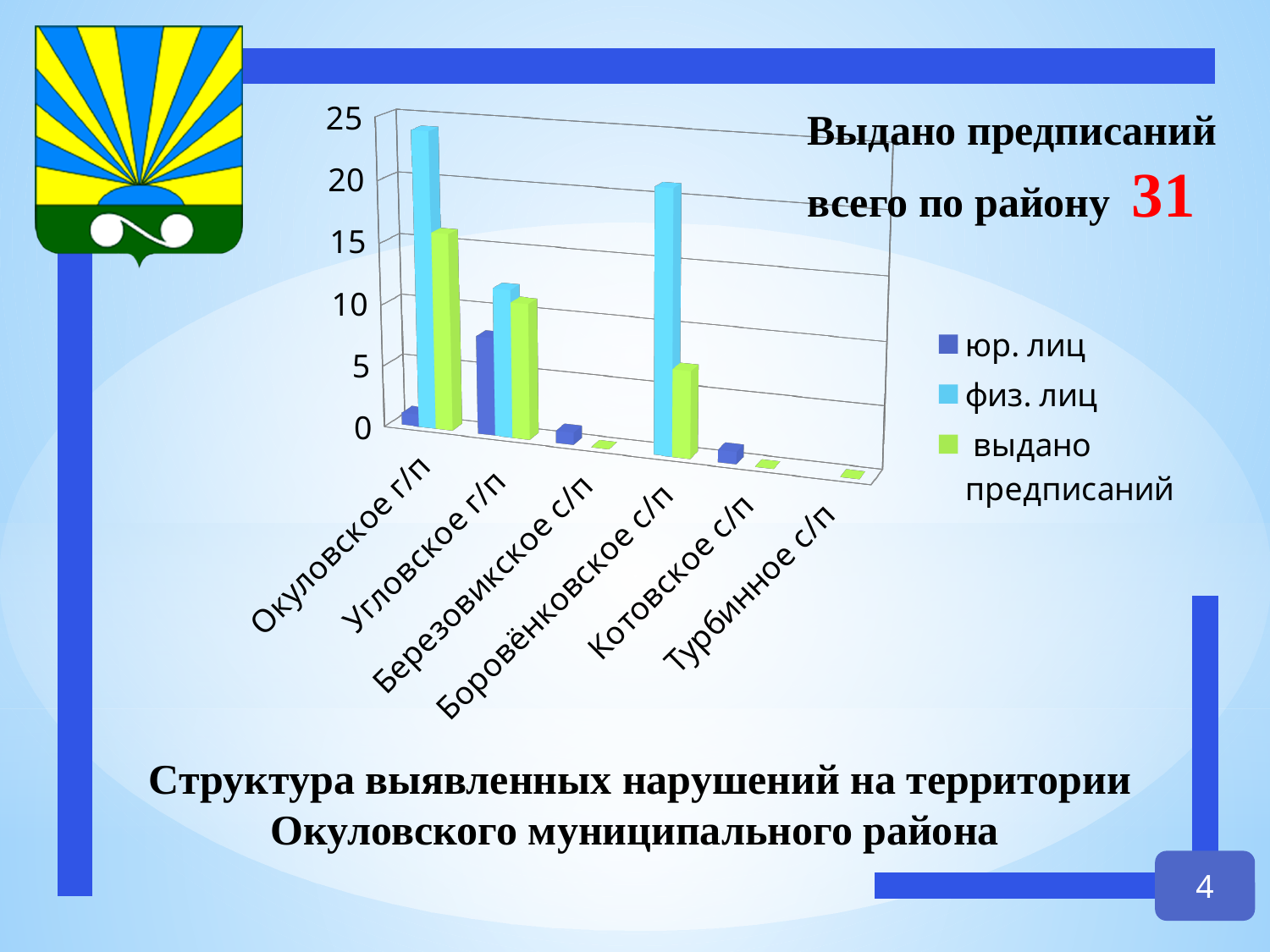
How many categories (settlements) are shown on the x axis of the chart? 6 Is the value for "физ. лиц" in Окуловское г/п greater or less than 20? greater Which is larger: the "физ. лиц" value for Угловское г/п or for Боровёнковское с/п? Боровёнковское с/п Is the value for "физ. лиц" in Боровёнковское с/п greater or less than 15? greater According to the text on the slide, how many предписаний were issued in total across the district? 31 Is the value for "выдано предписаний" in Боровёнковское с/п greater or less than 10? less Which category has the highest value for the series "юр. лиц"? Угловское г/п What kind of chart is shown on the slide? bar chart How many series does the chart legend list? 3 Which category has the highest value for the series "физ. лиц"? Окуловское г/п Which category has the highest value for the series "выдано предписаний"? Окуловское г/п What is the title of the chart at the bottom of the slide? Структура выявленных нарушений на территории Окуловского муниципального района